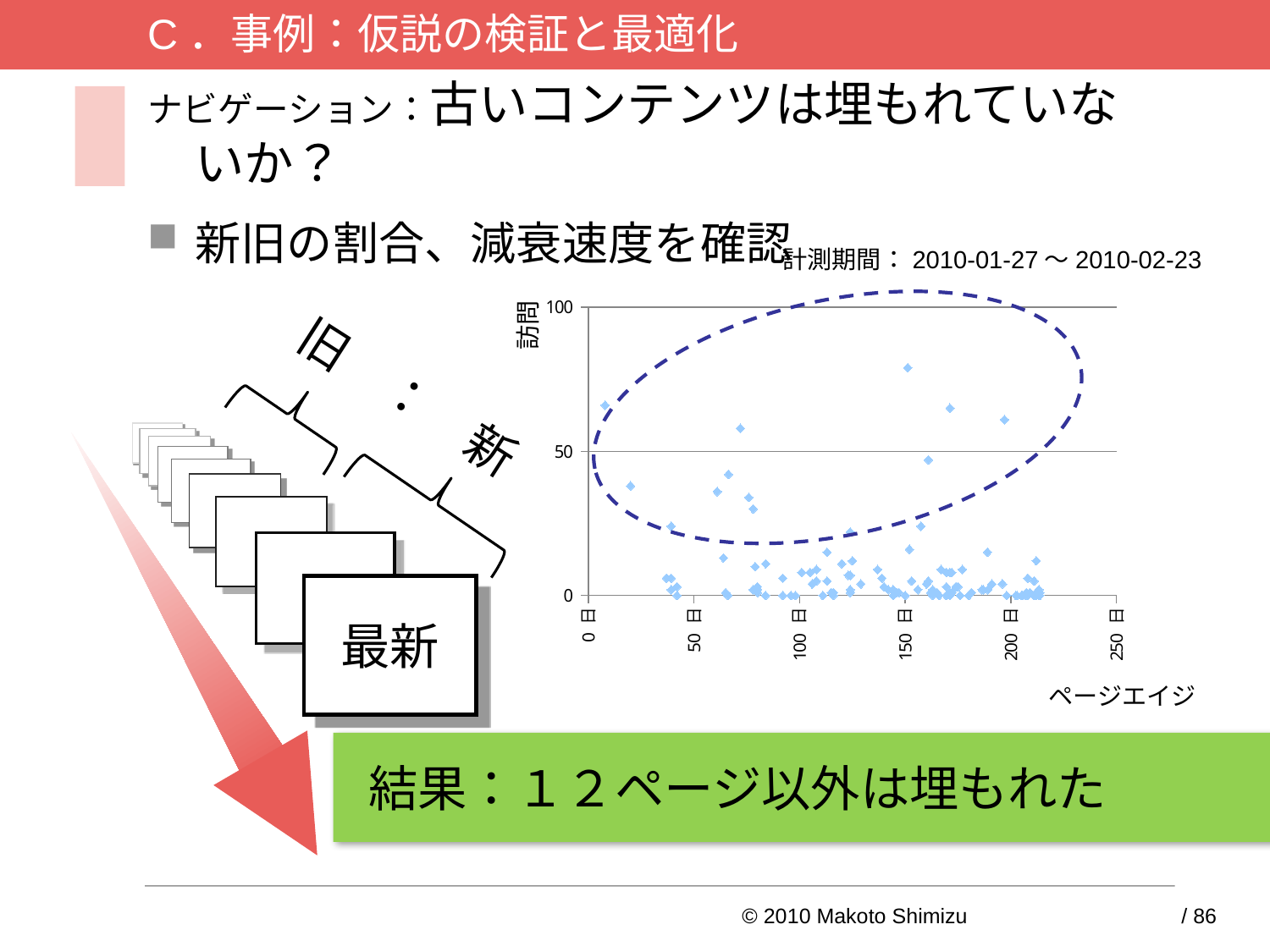
What is the label of the vertical axis of the scatter chart? 訪問 Is the highest plotted point in the scatter chart greater or less than 50 on the vertical axis? greater Do any plotted points in the scatter chart lie beyond 250 on the horizontal axis? No What measurement period is stated above the scatter chart? 2010-01-27 ～ 2010-02-23 Is the highest plotted point in the scatter chart greater or less than 100 on the vertical axis? less What is the last tick label shown on the horizontal axis of the scatter chart? 250日 What is the highest tick value shown on the vertical axis of the scatter chart? 100 What kind of chart is shown on the slide? scatter chart What is the label of the horizontal axis of the scatter chart? ページエイジ